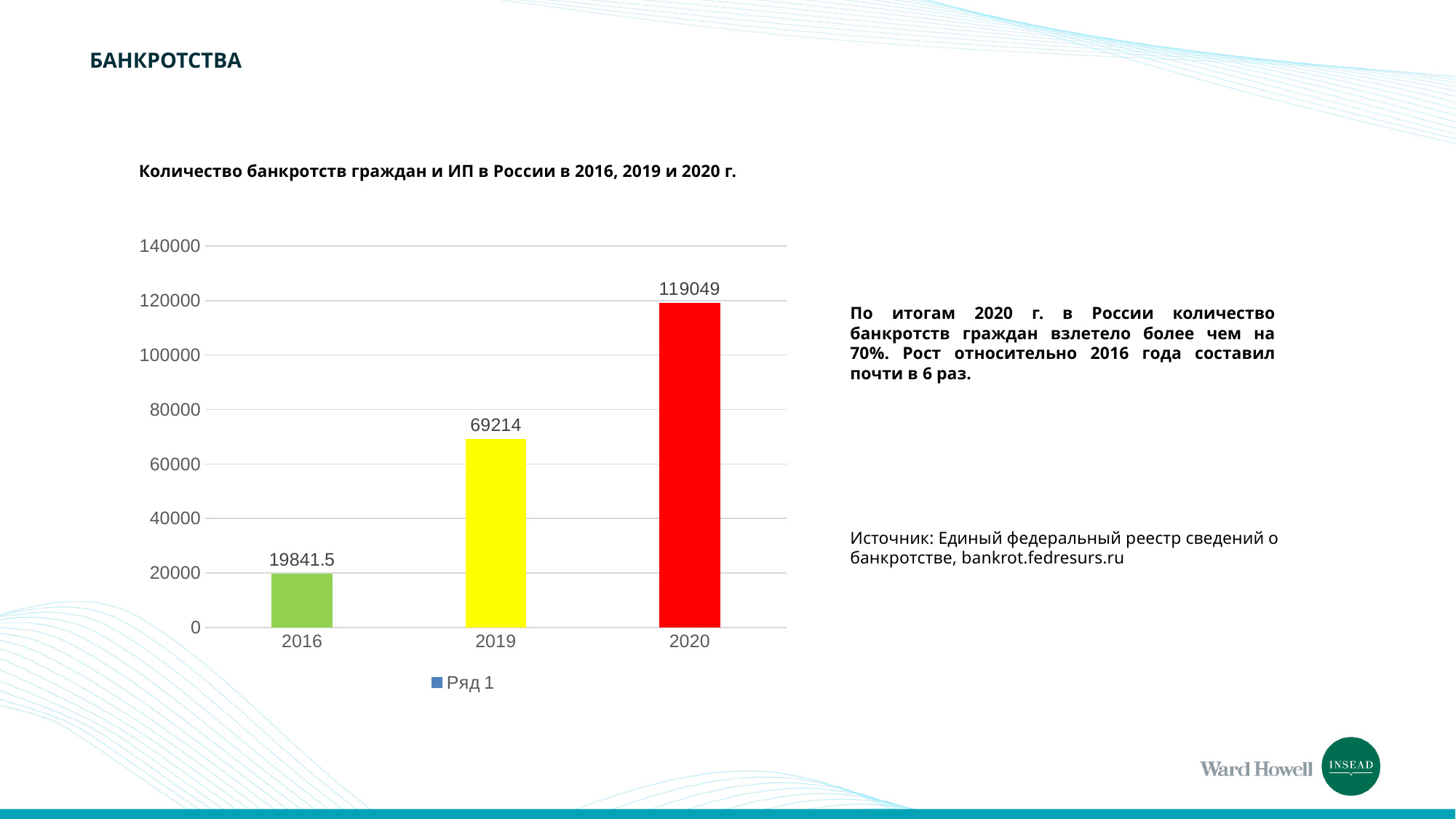
Which year has the highest value? 2020 What kind of chart is shown on the slide? bar chart What is the difference between the values for 2020 and 2019? 49835 Do the values rise or fall from 2016 to 2020? rise What is the value for 2019? 69214 Which year has the lowest value? 2016 How many years are shown on the x axis? 3 Is the value for 2020 greater or less than 100000? greater What is the difference between the values for 2019 and 2016? 49372.5 What is the value for 2016? 19841.5 Which is larger, the value for 2019 or the value for 2016? 2019 What is the value for 2020? 119049